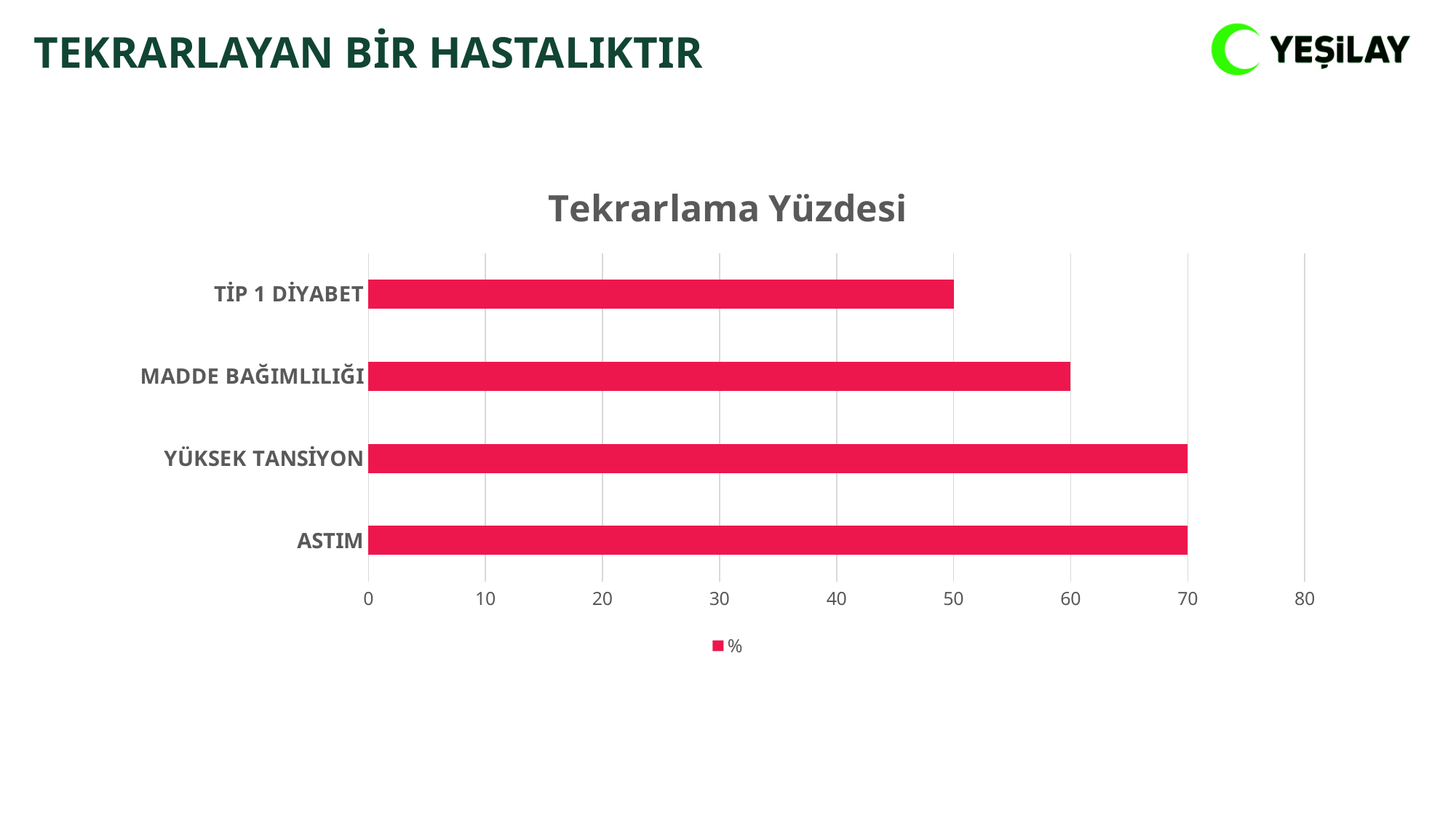
What is the difference between the values for YÜKSEK TANSİYON and TİP 1 DİYABET? 20 Is the value for ASTIM greater or less than 60? greater What is the title of the chart? Tekrarlama Yüzdesi What is the value for TİP 1 DİYABET? 50 What is the value for MADDE BAĞIMLILIĞI? 60 What is the value for YÜKSEK TANSİYON? 70 How many categories are shown in the chart? 4 What is the value for ASTIM? 70 Which is larger, the value for MADDE BAĞIMLILIĞI or the value for TİP 1 DİYABET? MADDE BAĞIMLILIĞI What kind of chart is shown on the slide? bar chart Which category has the lowest value? TİP 1 DİYABET What is the difference between the values for MADDE BAĞIMLILIĞI and TİP 1 DİYABET? 10